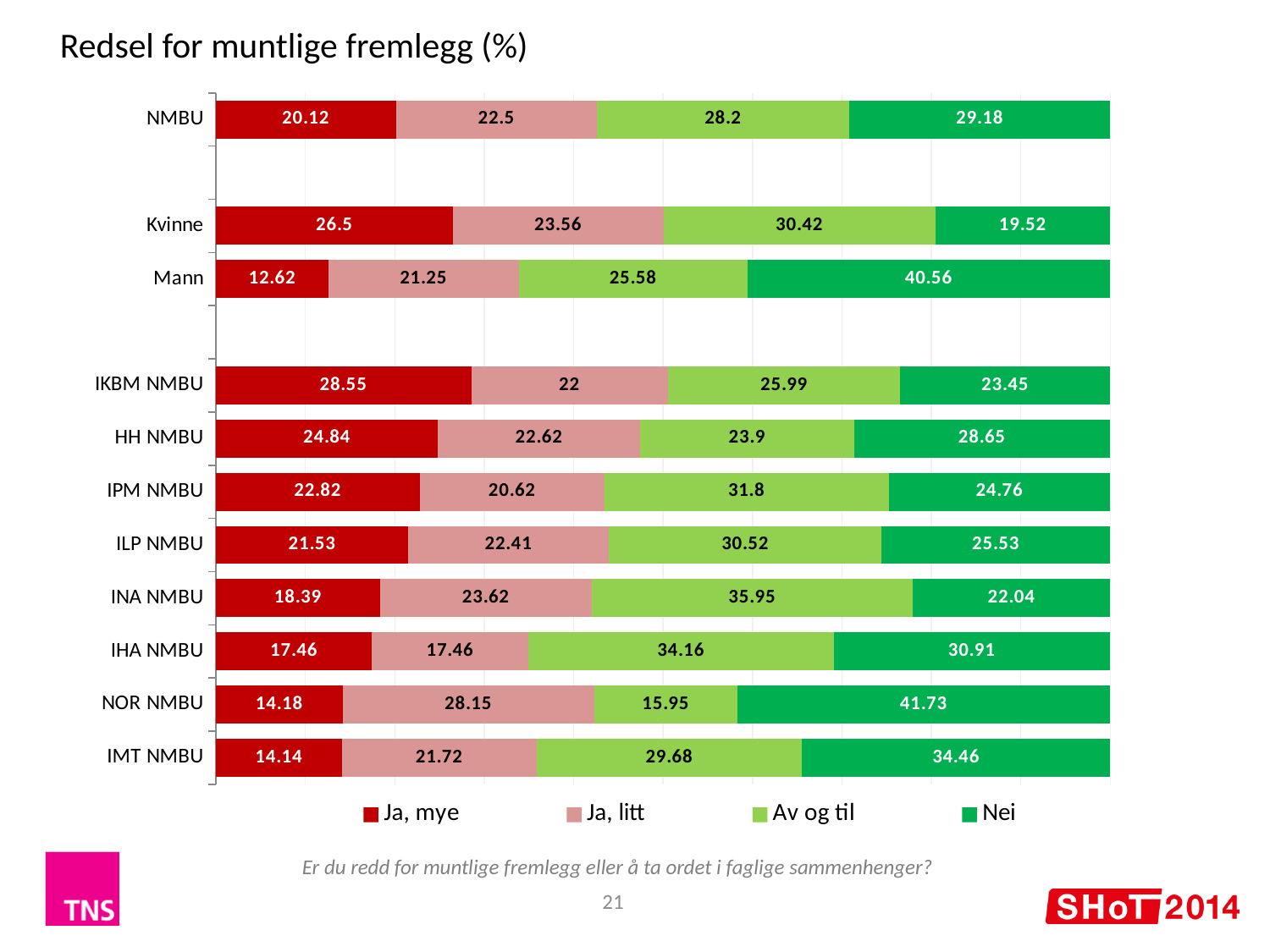
How many categories are shown on the y axis? 11 What is the total of the stacked bar for NMBU? 100 What is the value of "Av og til" for INA NMBU? 35.95 What is the value of "Nei" for Mann? 40.56 Which has a larger "Nei" value, IHA NMBU or IMT NMBU? IMT NMBU How many series does the legend list? 4 What is the difference between the "Ja, mye" values for Kvinne and Mann? 13.88 Which category has the highest value for "Ja, mye"? IKBM NMBU What kind of chart is shown? Stacked bar chart What is the value of "Ja, mye" for Kvinne? 26.5 Which category has the lowest value for "Av og til"? NOR NMBU What is the title of the chart? Redsel for muntlige fremlegg (%)